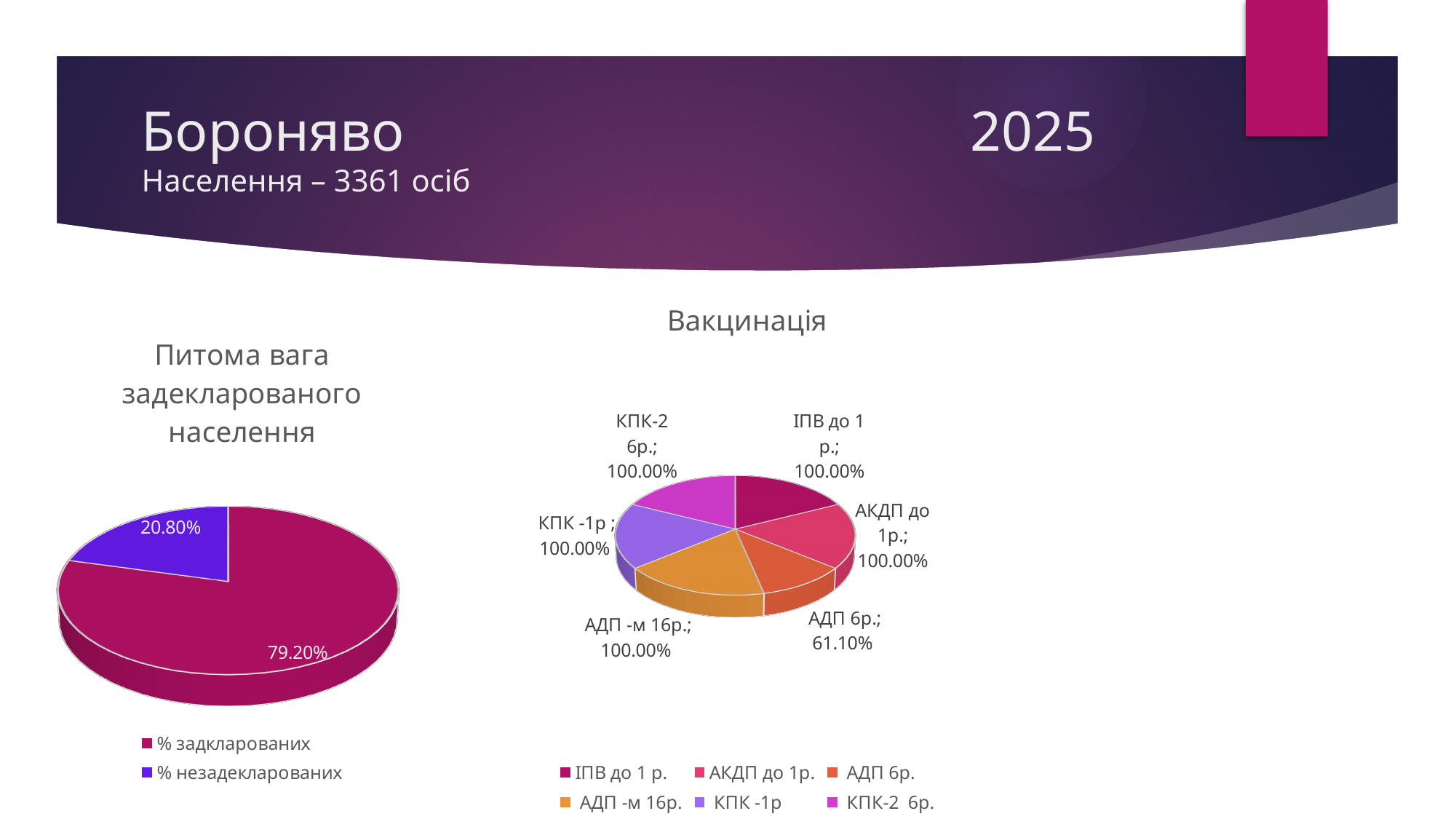
In the chart titled "Питома вага задекларованого населення", which category has the larger share? % задкларованих In the chart titled "Вакцинація", which category has the lowest value? АДП 6р. What kind of chart is the one titled "Питома вага задекларованого населення"? pie chart In the chart titled "Вакцинація", what is the value for "КПК -1р"? 100.00% In the chart titled "Вакцинація", how many categories are shown? 6 In the chart titled "Питома вага задекларованого населення", what is the value for "% задкларованих"? 79.20% In the chart titled "Питома вага задекларованого населення", what is the value for "% незадекларованих"? 20.80% How many entries does the legend of the chart titled "Питома вага задекларованого населення" list? 2 In the chart titled "Вакцинація", is the value for "ІПВ до 1 р." larger or smaller than the value for "АДП 6р."? larger In the chart titled "Вакцинація", what is the value for "АДП 6р."? 61.10% In the chart titled "Питома вага задекларованого населення", what is the difference between the two slices? 58.40% In the chart titled "Вакцинація", what is the difference between the values for "АДП -м 16р." and "АДП 6р."? 38.90%